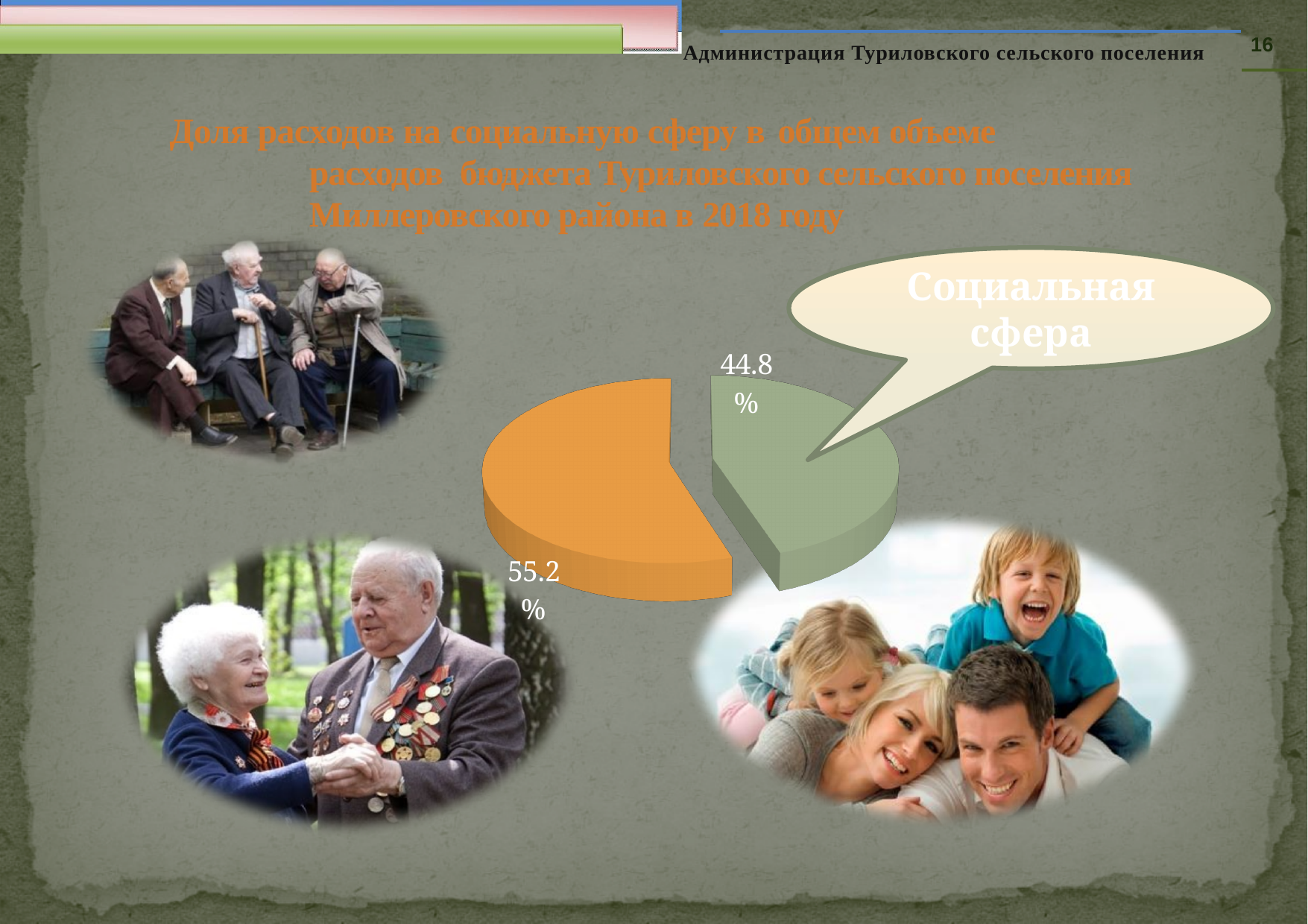
How many slices does the pie chart have? 2 What is the difference between the two slices of the pie chart, in percentage points? 10.4 What kind of chart is shown on the slide? Pie chart What value is printed on the orange slice of the pie chart? 55.2% Which year does the chart title refer to? 2018 What value is printed on the green slice of the pie chart? 44.8% What do the two slices of the pie chart add up to? 100% Which slice of the pie chart is the largest? The orange slice (55.2%) Which is larger: the orange slice or the "Социальная сфера" slice? The orange slice What share of the pie is labelled "Социальная сфера"? 44.8% Which slice of the pie chart is the smallest? Социальная сфера (44.8%) Which slice does the callout "Социальная сфера" point to? The green slice